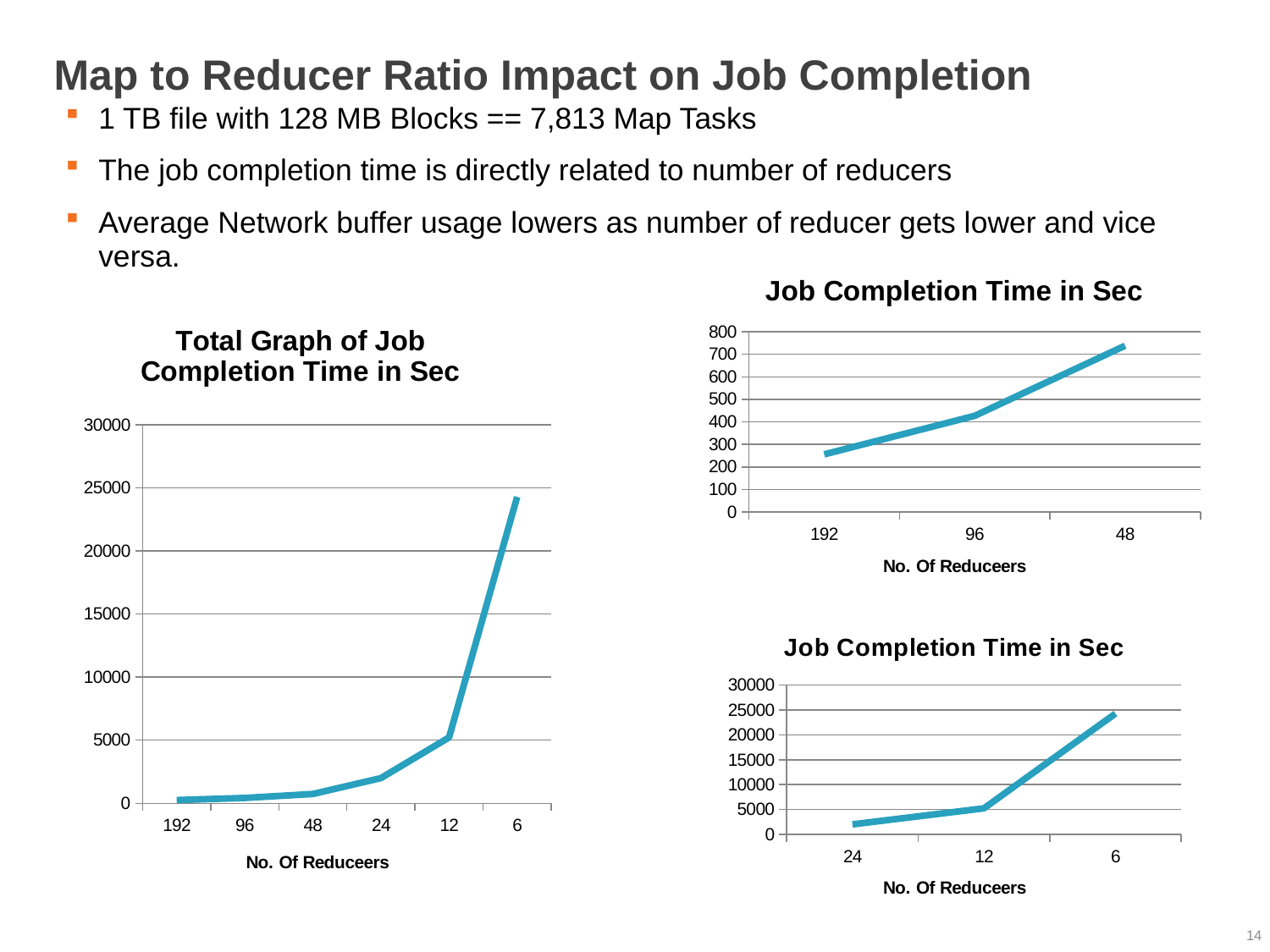
In the bottom-right 'Job Completion Time in Sec' chart, which is larger, the value for 6 reducers or the value for 24 reducers? 6 reducers In the 'Total Graph of Job Completion Time in Sec' chart, which number of reducers has the highest job completion time? 6 In the 'Total Graph of Job Completion Time in Sec' chart, is the value for 24 reducers greater or less than 5000? less What is the x-axis title of the bottom-right 'Job Completion Time in Sec' chart? No. Of Reduceers In the 'Total Graph of Job Completion Time in Sec' chart, do the values rise or fall moving left to right along the x axis? rise How many reducer counts are plotted on the x axis of the 'Total Graph of Job Completion Time in Sec' chart? 6 In the 'Total Graph of Job Completion Time in Sec' chart, is the value for 6 reducers greater or less than 20000? greater In the top-right 'Job Completion Time in Sec' chart, is the value for 48 reducers greater or less than 600? greater In the 'Total Graph of Job Completion Time in Sec' chart, which number of reducers has the lowest job completion time? 192 What kind of chart is the 'Total Graph of Job Completion Time in Sec' chart on the left? line chart How many reducer counts are plotted in the top-right 'Job Completion Time in Sec' chart? 3